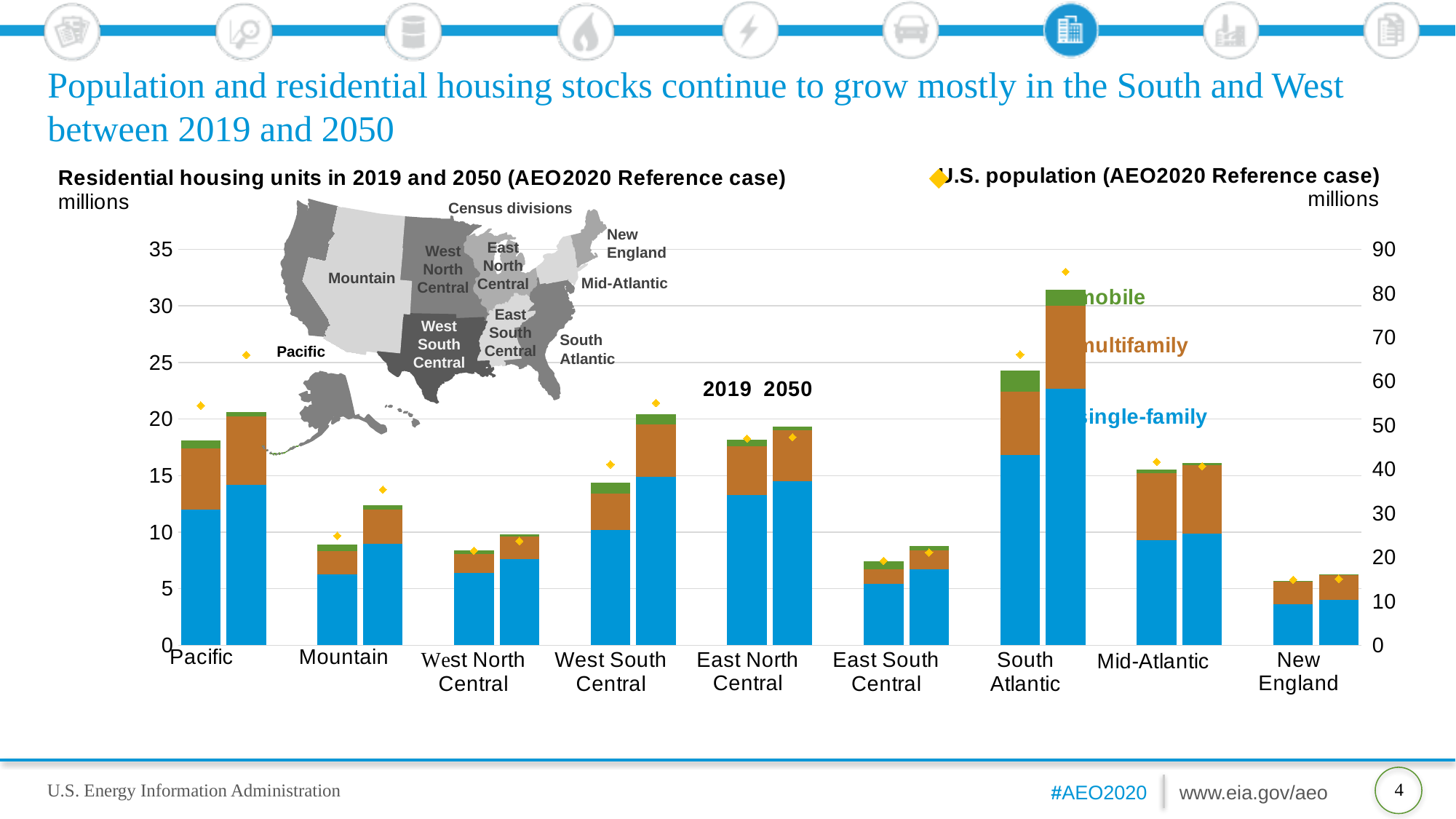
How many housing types does the legend list for the stacked bars? 3 What kind of chart is used to show residential housing units by census division? Stacked bar chart Is the total residential housing units for Mountain in 2019 greater or less than 10 million? less Which has more total residential housing units in 2050, Pacific or Mountain? Pacific Which census division has the shortest stacked bars for residential housing units? New England Is the total residential housing units for Pacific in 2050 greater or less than 15 million? greater How many census divisions are shown on the x axis of the housing units chart? 9 Is the total residential housing units for South Atlantic in 2050 greater or less than 25 million? greater Which colour represents single-family housing units in the stacked bars? Blue For Pacific, do total residential housing units rise or fall from 2019 to 2050? rise Which has more total residential housing units in 2050, West South Central or Mid-Atlantic? West South Central Which census division has the tallest stacked bar for residential housing units? South Atlantic